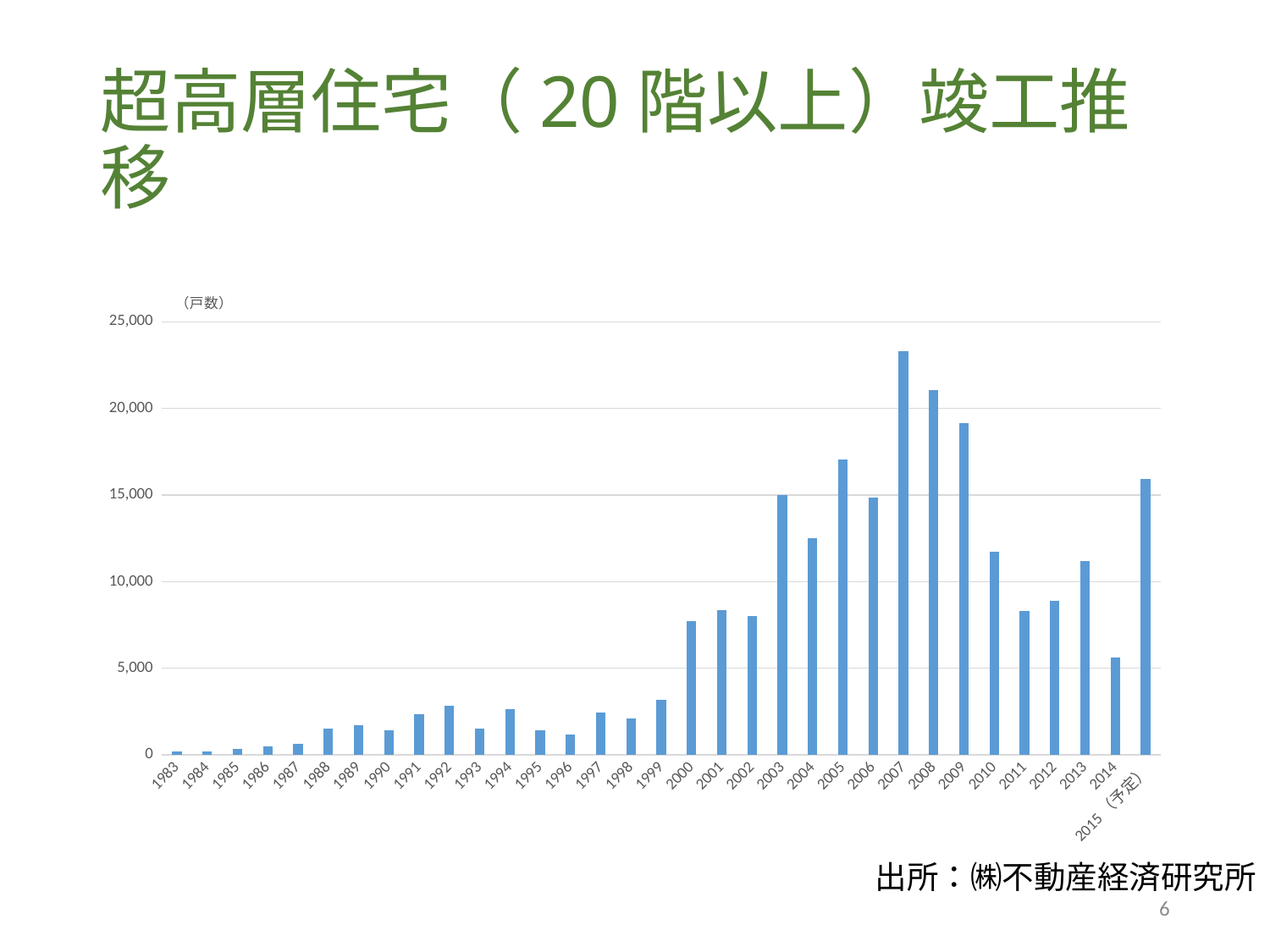
How many years (categories) are shown on the x axis? 33 Which is larger, the value for 2004 or the value for 2005? 2005 Is the value for 1999 greater or less than 5,000? less Is the value for 2010 greater or less than 10,000? greater What kind of chart is shown on the slide? bar chart What unit label is shown above the y axis? （戸数） Is the value for 2009 greater or less than 20,000? less Which year has the highest value in the chart? 2007 Which is larger, the value for 2014 or the value for 2015 (予定)? 2015 (予定) Do the values rise or fall from 2007 to 2010? fall